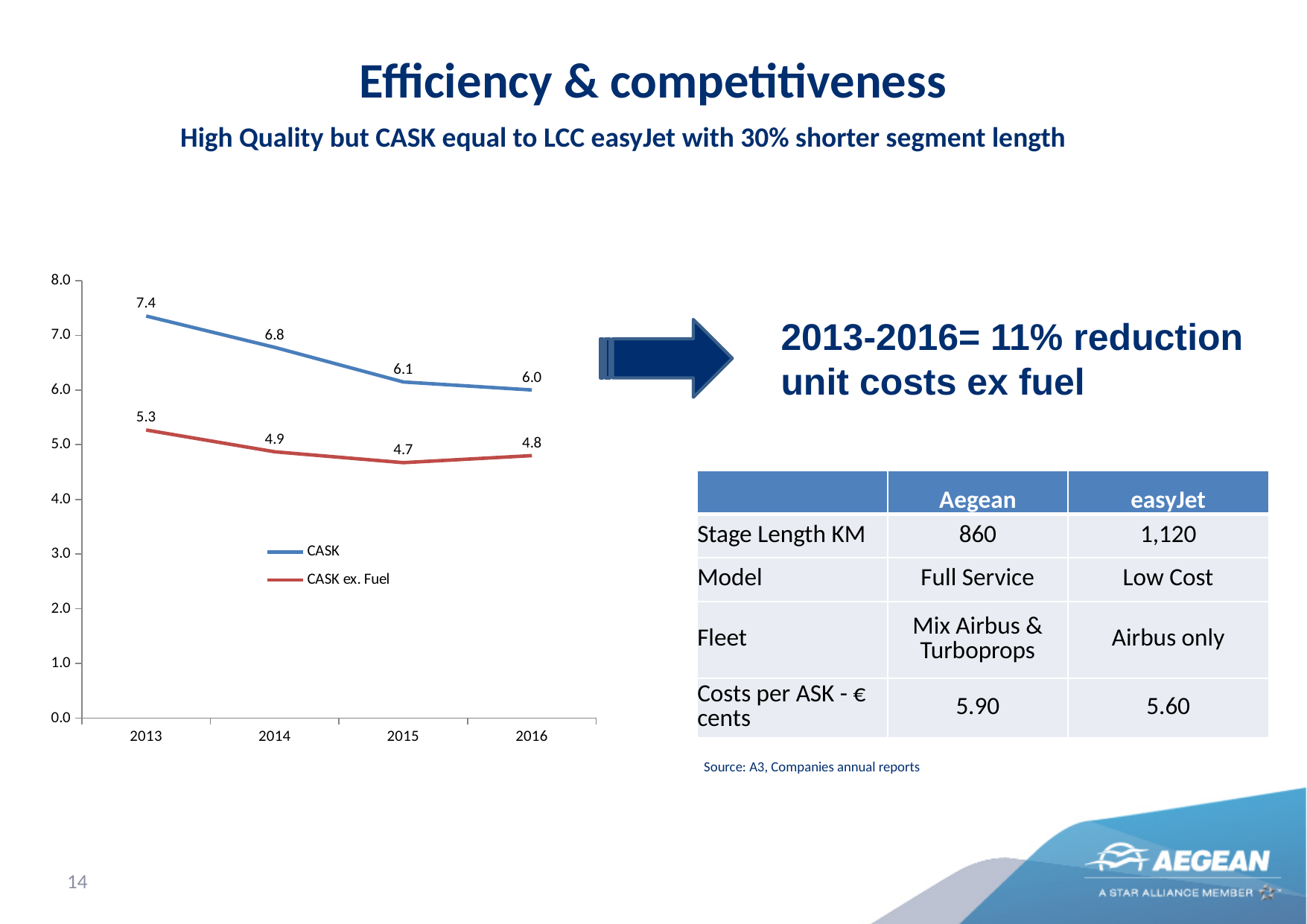
What is the CASK value for 2016? 6.0 How many series does the chart legend list? 2 How many years are shown on the x axis of the chart? 4 By how much did CASK fall from 2013 to 2016? 1.4 What kind of chart is shown on the slide? Line chart In which year is CASK highest? 2013 Which is larger, CASK ex. Fuel in 2014 or in 2016? 2014 Does the CASK series rise or fall from 2013 to 2016? Fall In which year is CASK ex. Fuel lowest? 2015 What is the difference between CASK and CASK ex. Fuel in 2014? 1.9 What is the CASK value for 2013? 7.4 What is the CASK ex. Fuel value for 2015? 4.7